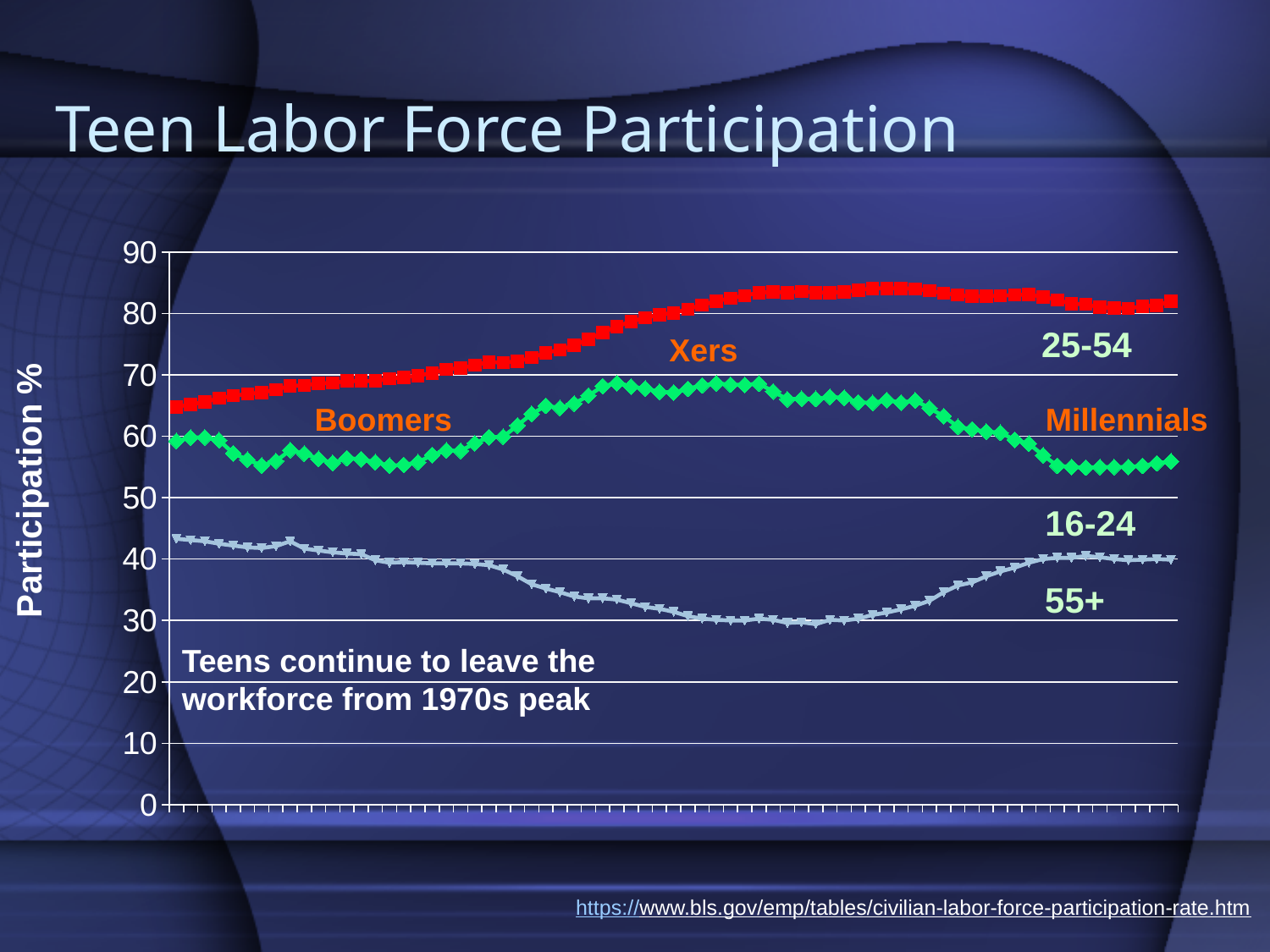
Is the value for the 55+ series at the left end of the chart greater or less than 40? greater Is the value for the 16-24 series at the left end of the chart greater or less than 50? greater What is the title of the slide containing the chart? Teen Labor Force Participation Which age-group series has the highest participation rate throughout the chart? 25-54 Is the value for the 16-24 series at the right end of the chart greater or less than 50? greater Does the 25-54 series generally rise or fall from left to right across the chart? rise What kind of chart is shown on the slide? line chart What is the label on the vertical axis of the chart? Participation % Which age-group series has the lowest participation rate throughout the chart? 55+ How many age-group series are plotted on the chart? 3